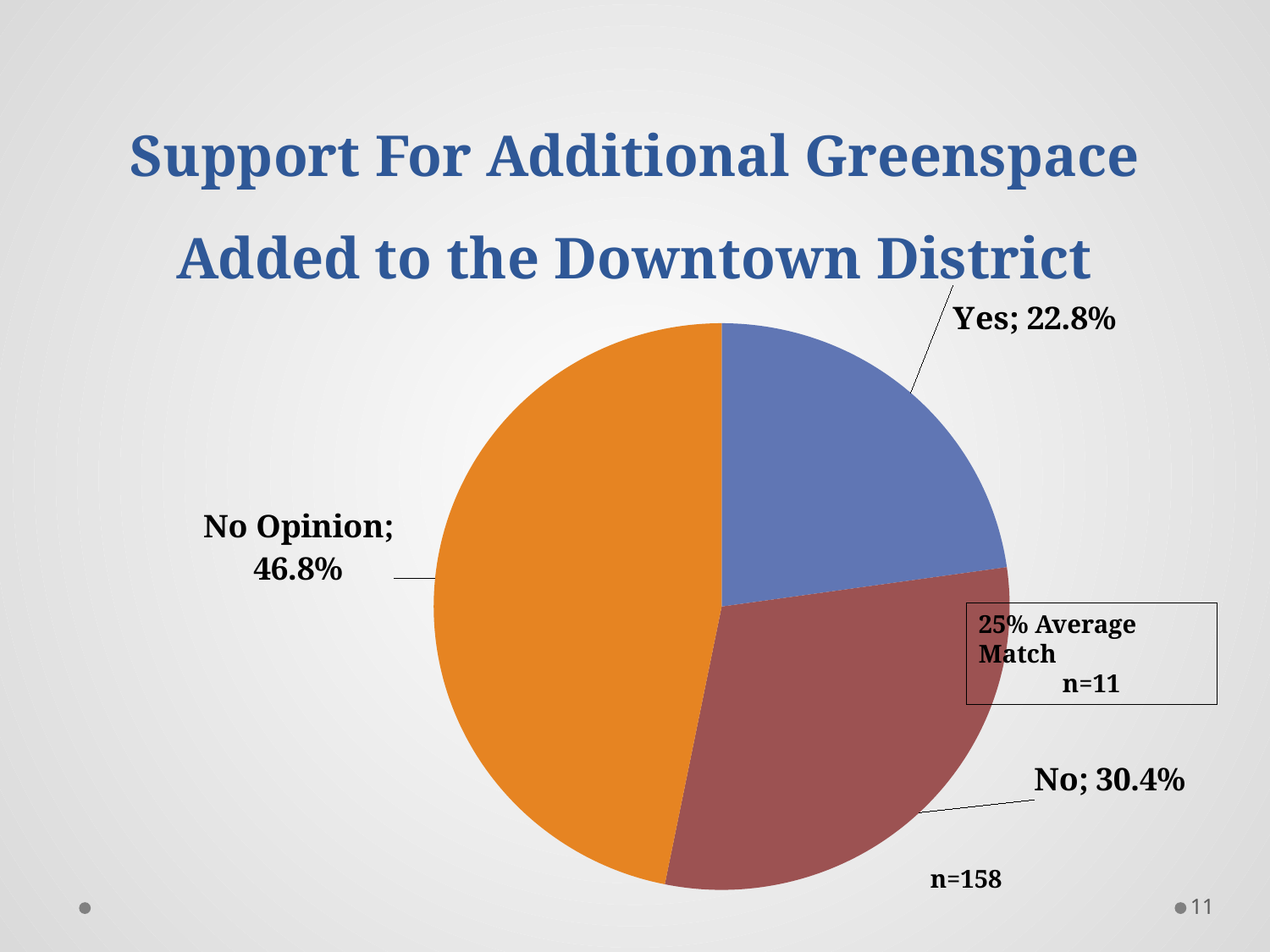
What percentage of respondents answered Yes? 22.8% What is the sample size (n) shown for the pie chart? n=158 What percentage of respondents had No Opinion? 46.8% Which response category has the smallest share of the pie? Yes What percentage of respondents answered No? 30.4% What type of chart is shown on the slide? Pie chart What is the difference in percentage points between No and Yes? 7.6 What is the title of the chart? Support For Additional Greenspace Added to the Downtown District How many slices does the pie chart have? 3 What is the difference in percentage points between No Opinion and No? 16.4 Which is larger, the share for Yes or the share for No? No Which response category has the largest share of the pie? No Opinion